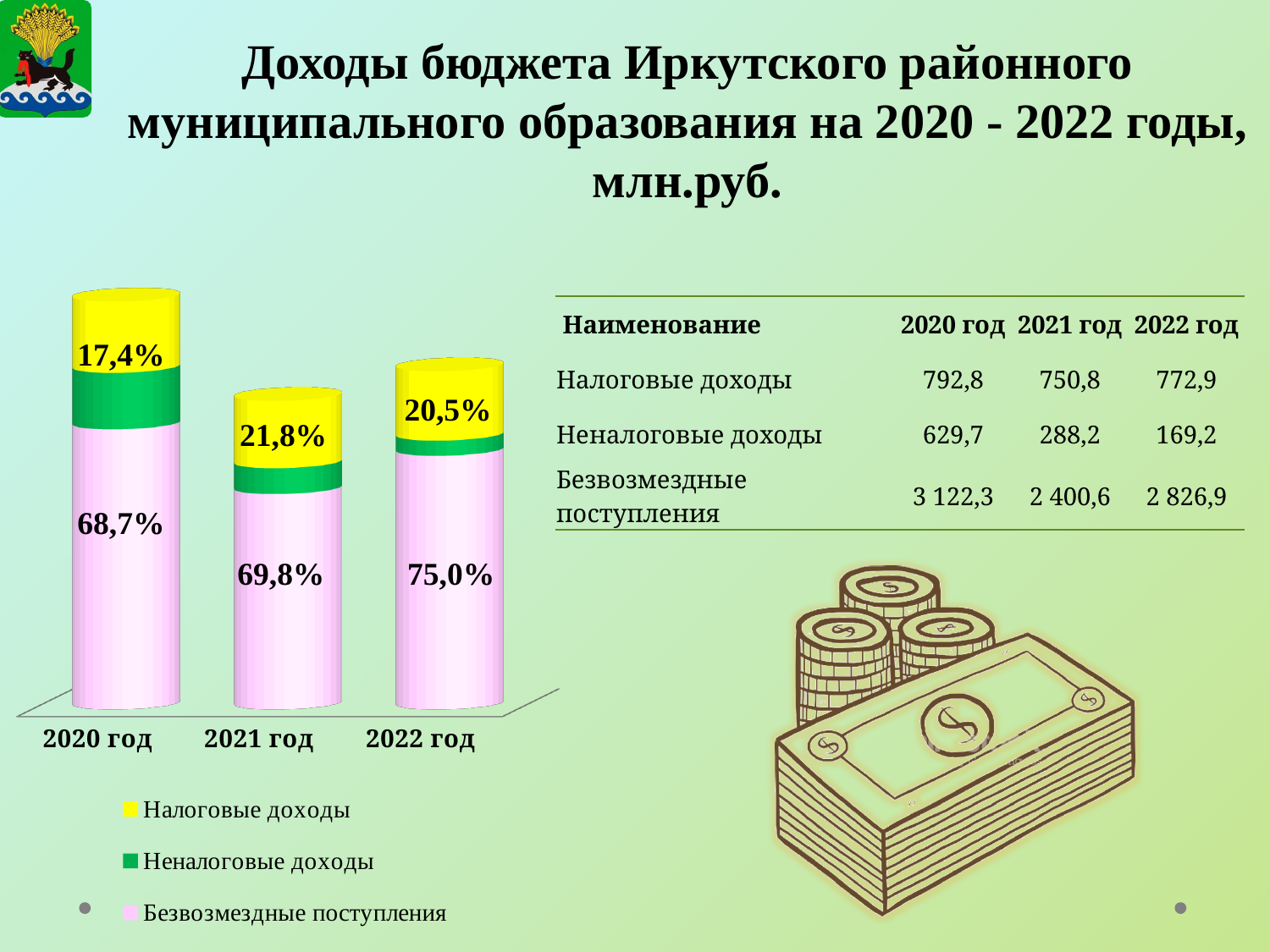
What is the labelled share of Безвозмездные поступления for 2021 год? 69,8% In which year is the share of Налоговые доходы the lowest? 2020 год What is the labelled share of Налоговые доходы for 2021 год? 21,8% What share does Налоговые доходы have in the 2020 год bar? 17,4% In which year is the share of Безвозмездные поступления the highest? 2022 год How many years (bars) are shown on the chart? 3 Which year has the larger share of Налоговые доходы, 2021 год or 2022 год? 2021 год Which colour represents Неналоговые доходы in the chart? Green What type of chart is shown on the slide? Stacked bar chart What share does Безвозмездные поступления have in the 2022 год bar? 75,0% How many series does the chart legend list? 3 By how many percentage points does the Безвозмездные поступления share in 2022 год exceed that in 2020 год? 6,3 percentage points